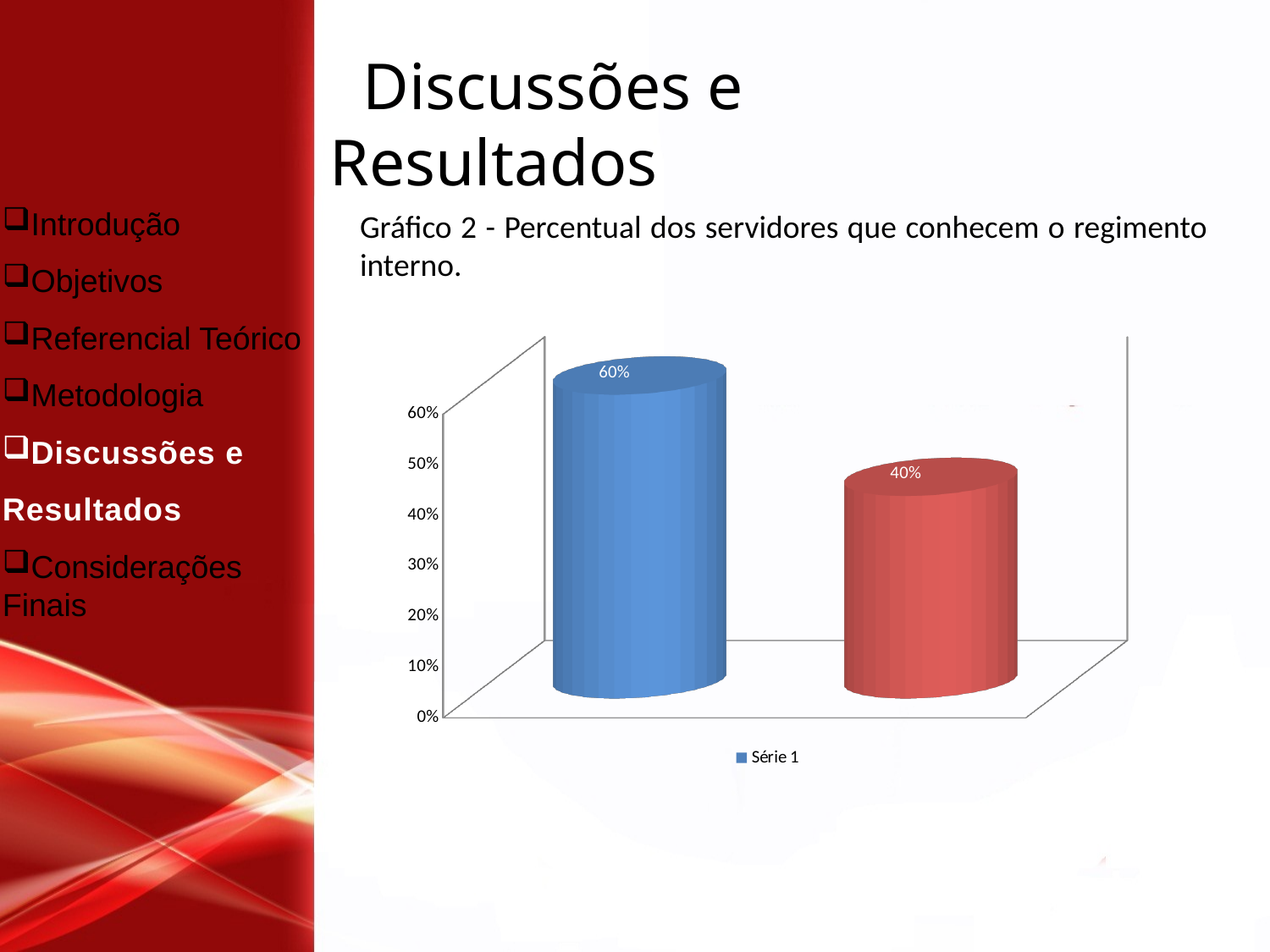
Is the value of the red bar larger or smaller than the value of the blue bar? smaller Is the value of the blue bar greater or less than 50%? greater Is the value of the red bar greater or less than 50%? less What kind of chart is shown on the slide? bar chart Which bar has the lowest value, the blue one or the red one? the red bar What is the difference between the value of the blue bar and the value of the red bar? 20% How many series does the legend list? 1 How many bars are plotted in the chart? 2 What is the name of the series listed in the legend? Série 1 What value is shown on the red bar? 40% What value is shown on the blue bar? 60% Which bar has the highest value, the blue one or the red one? the blue bar